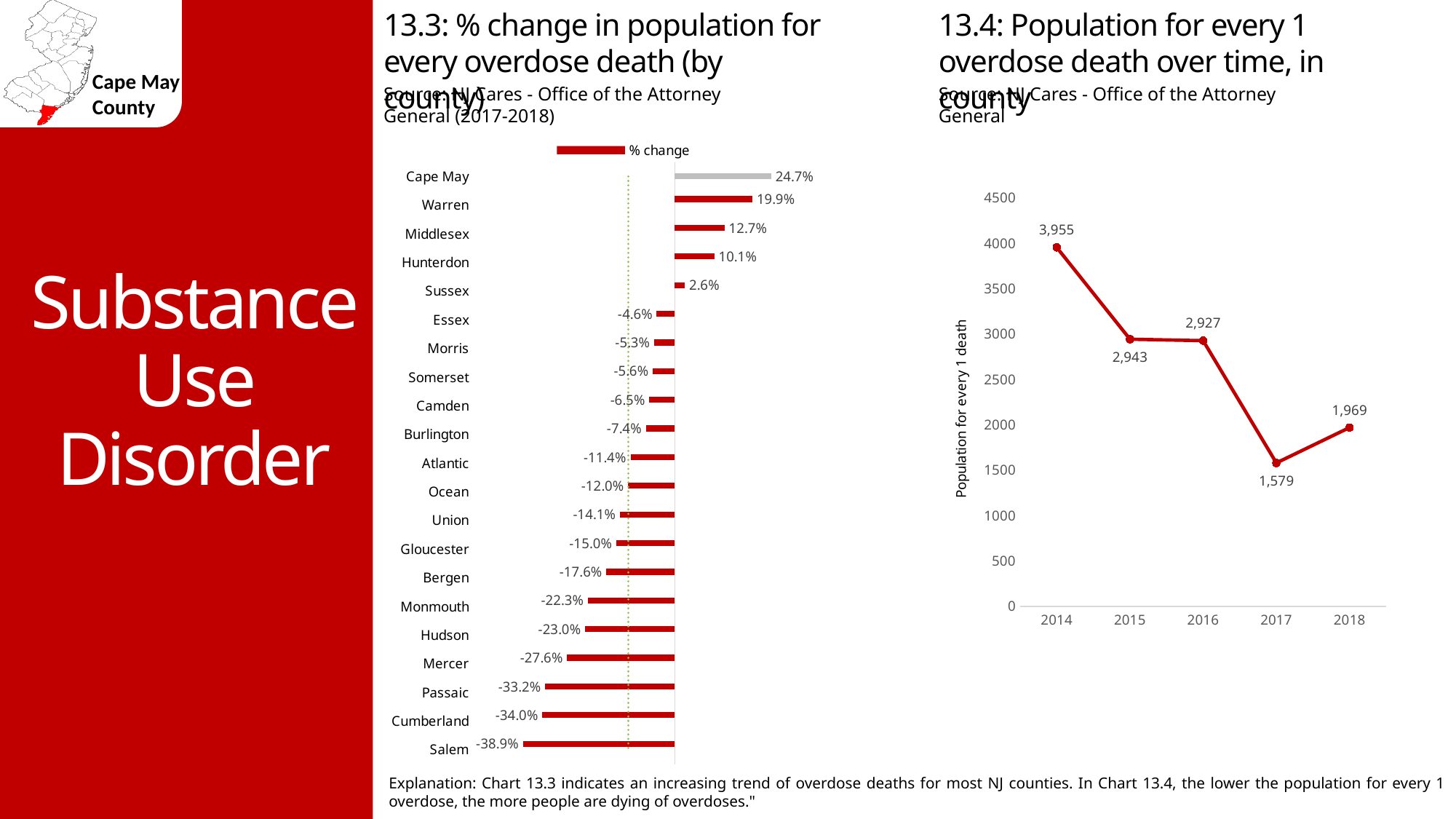
In chart 13.3, how many counties are shown? 21 In chart 13.4, what is the difference between the values for 2014 and 2018? 1,986 In chart 13.3, which county has the highest % change? Cape May In chart 13.4, what is the population for every 1 overdose death in 2014? 3,955 In chart 13.3, what is the % change for Cape May? 24.7% What kind of chart is chart 13.3? Bar chart In chart 13.3, what is the difference between the % change for Warren and Middlesex? 7.2 percentage points What kind of chart is chart 13.4? Line chart In chart 13.3, which county has the lowest % change? Salem In chart 13.3, what is the % change for Salem? -38.9% In chart 13.4, which year has the lowest population for every 1 overdose death? 2017 In chart 13.3, which county has a larger % change, Hudson or Mercer? Hudson